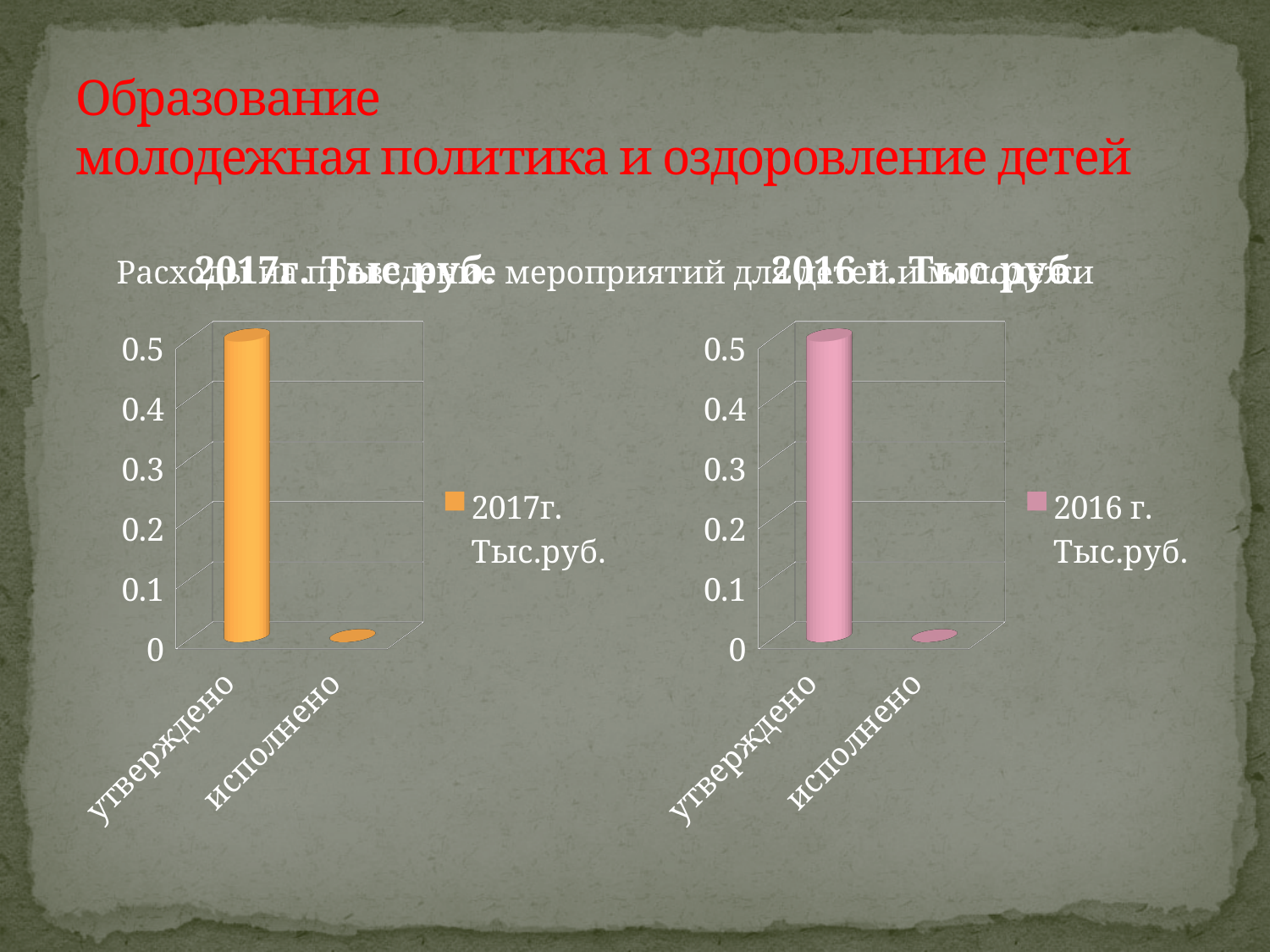
What kind of chart is the left chart titled "2017г. Тыс.руб."? bar chart How many series does the legend of the left chart (2017г. Тыс.руб.) list? 1 In the left chart (2017г. Тыс.руб.), how many categories are shown on the x axis? 2 In the left chart (2017г. Тыс.руб.), is the value for утверждено greater or less than 0.4? greater What is the legend entry of the right chart? 2016 г. Тыс.руб. What kind of chart is the right chart titled "2016 г. Тыс.руб."? bar chart In the right chart (2016 г. Тыс.руб.), is the value for исполнено greater or less than 0.1? less In the right chart (2016 г. Тыс.руб.), which category has the highest value? утверждено In the right chart (2016 г. Тыс.руб.), how many categories are shown on the x axis? 2 In the left chart (2017г. Тыс.руб.), which category has the highest value? утверждено In the right chart (2016 г. Тыс.руб.), which category has the lowest value? исполнено In the left chart (2017г. Тыс.руб.), which category has the lowest value? исполнено